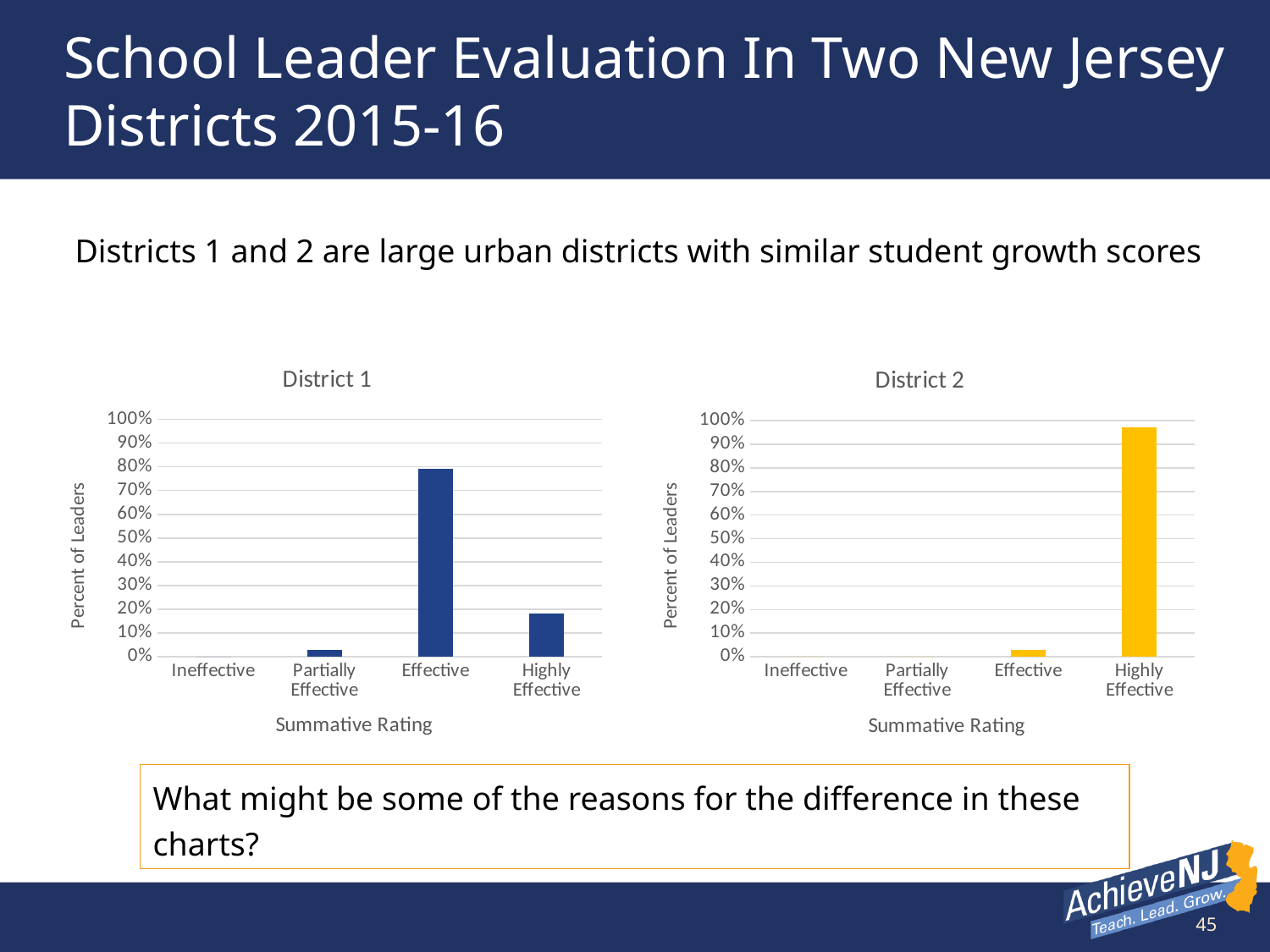
In the District 2 chart, is the value for Highly Effective greater or less than 90%? greater What is the y-axis label on the District 1 chart? Percent of Leaders What kind of chart is the District 2 chart? bar chart What colour are the bars in the District 2 chart? yellow In the District 2 chart, is the value for Effective greater or less than 10%? less How many summative rating categories are shown on the x axis of the District 1 chart? 4 In the District 2 chart, which summative rating has the highest percent of leaders? Highly Effective In the District 1 chart, which summative rating has the highest percent of leaders? Effective In the District 1 chart, which is larger, the value for Effective or the value for Highly Effective? Effective In the District 1 chart, is the value for Highly Effective greater or less than 20%? less In the District 2 chart, which is larger, the value for Highly Effective or the value for Effective? Highly Effective